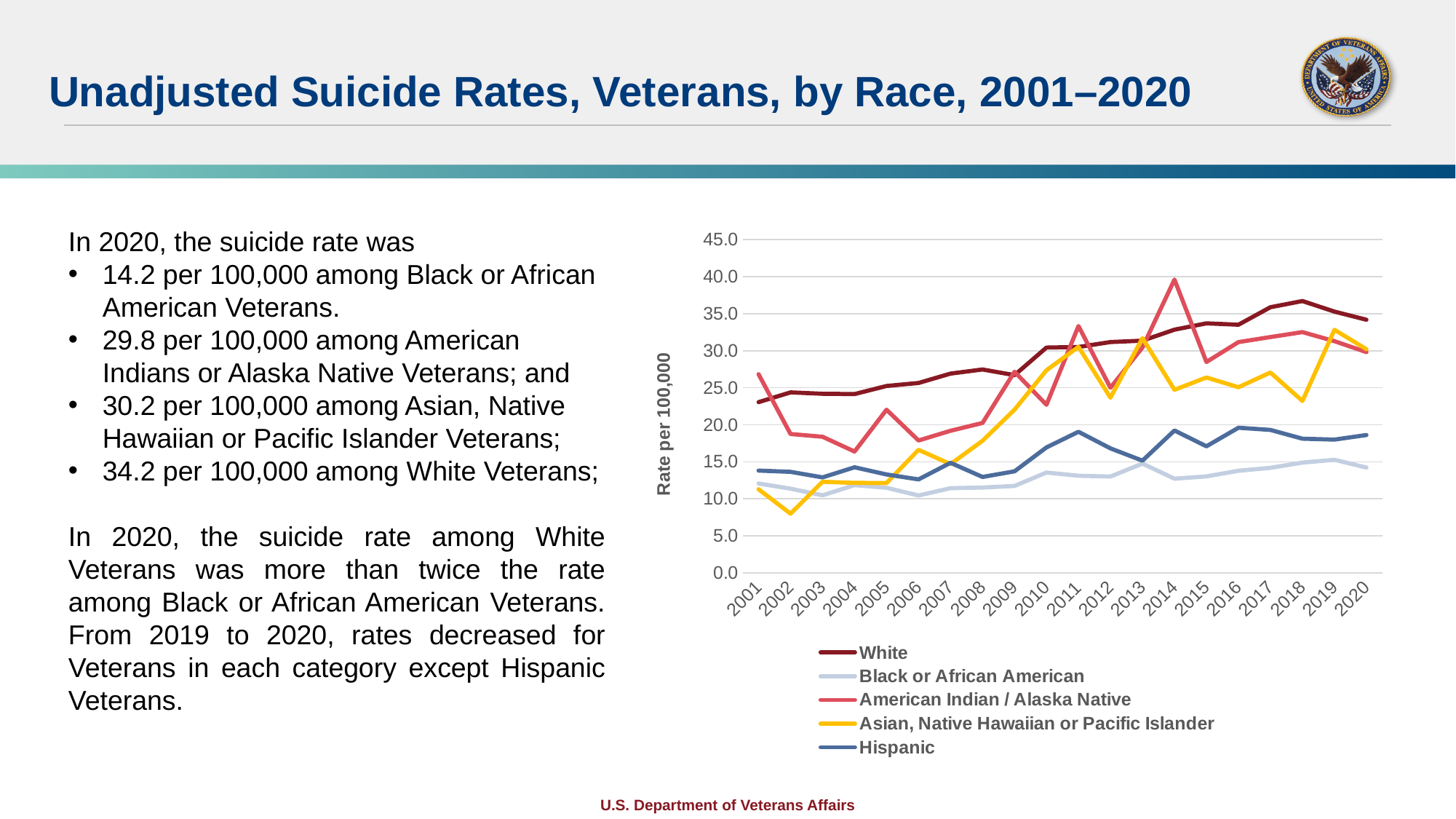
Which series has the lowest value in 2020? Black or African American How many years are shown along the x axis of the chart? 20 What is the difference between the 2020 rates for White Veterans and Black or African American Veterans? 20.0 In 2020, which rate is larger: Asian, Native Hawaiian or Pacific Islander Veterans or American Indian / Alaska Native Veterans? Asian, Native Hawaiian or Pacific Islander How many series does the legend list? 5 Is the value for Hispanic Veterans in 2020 greater or less than 20.0? less What is the label on the y axis of the chart? Rate per 100,000 What is the 2020 suicide rate per 100,000 among Black or African American Veterans? 14.2 In which year does the American Indian / Alaska Native line reach its highest point? 2014 What kind of chart is shown on the slide? line chart What is the 2020 suicide rate per 100,000 among White Veterans? 34.2 Which series has the highest value in 2020? White